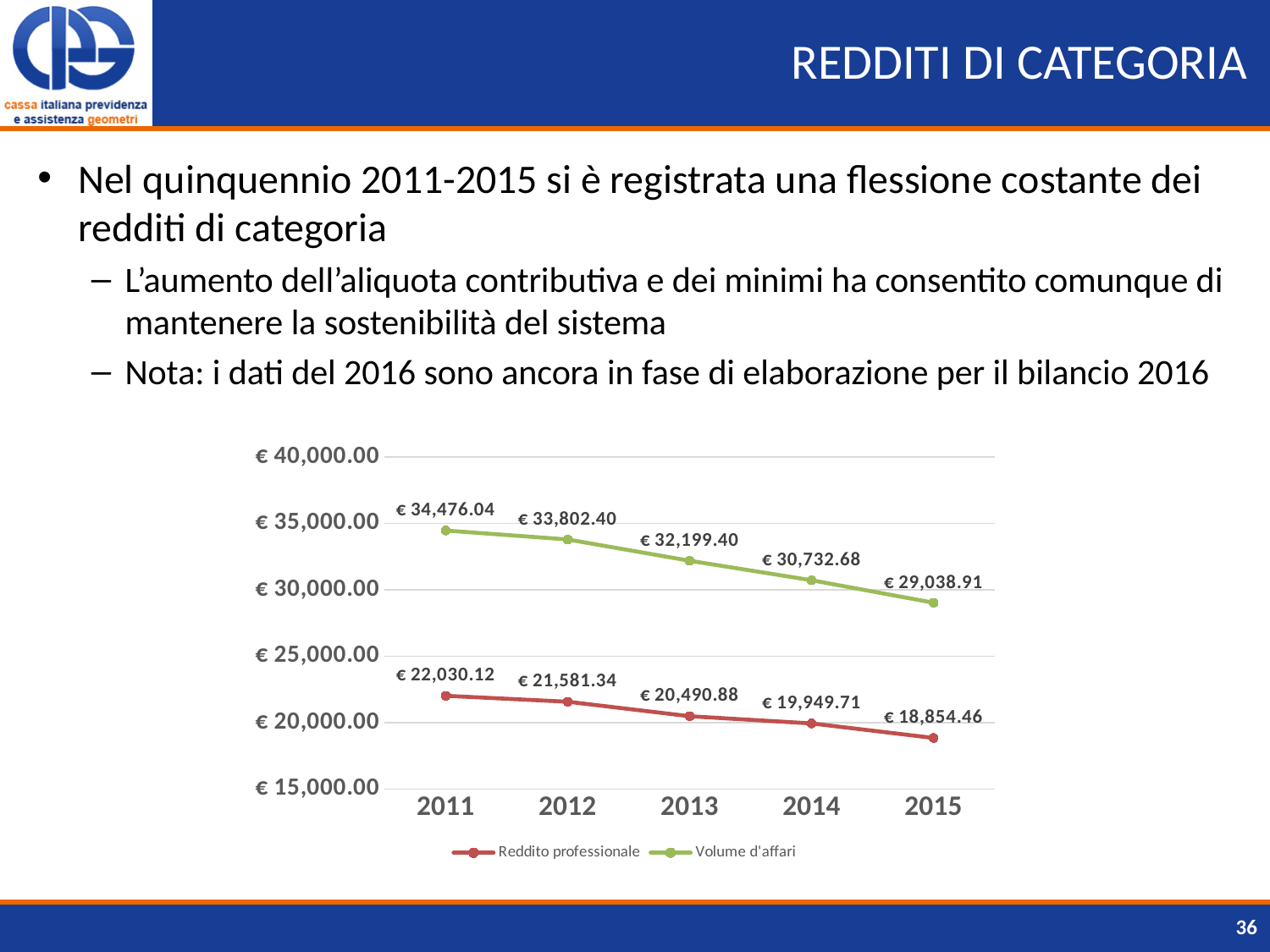
Which is larger in 2014, Volume d'affari or Reddito professionale? Volume d'affari What is the value of Reddito professionale in 2015? € 18,854.46 What is the value of Reddito professionale in 2011? € 22,030.12 How many years are shown on the x axis? 5 What kind of chart is shown on the slide? Line chart By how much did Volume d'affari decrease from 2011 to 2015? € 5,437.13 In which year is Reddito professionale lowest? 2015 In which year is Volume d'affari highest? 2011 How many series does the legend list? 2 Do the values of Reddito professionale rise or fall from 2011 to 2015? Fall What is the difference between Volume d'affari and Reddito professionale in 2011? € 12,445.92 What is the value of Volume d'affari in 2013? € 32,199.40